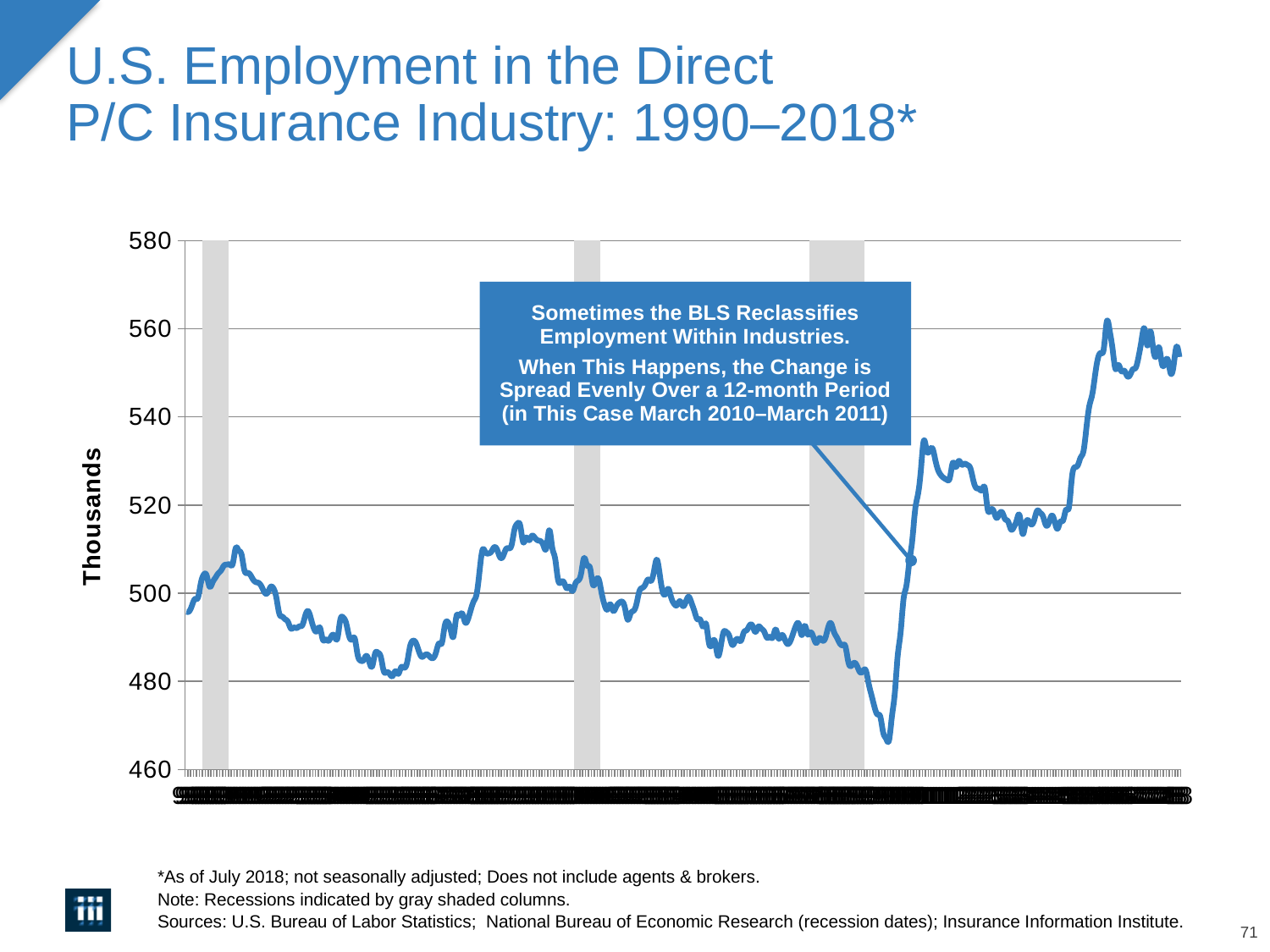
Is the lowest point of the employment line greater or less than 480? less Is the employment value at the end of the series (2018) higher or lower than at the start (1990)? higher What is the label on the vertical axis of the chart? Thousands How many data series are plotted on the chart? 1 How many gray shaded recession columns appear on the chart? 3 What kind of chart is shown on the slide? line chart Does the employment line rise or fall sharply immediately after the third (rightmost) gray recession column? rise What is the title of the chart on the slide? U.S. Employment in the Direct P/C Insurance Industry: 1990–2018* Is the employment value at the end of the series (2018) greater or less than 540? greater Is the highest point of the employment line greater or less than 540? greater What is the maximum value shown on the vertical axis of the chart? 580